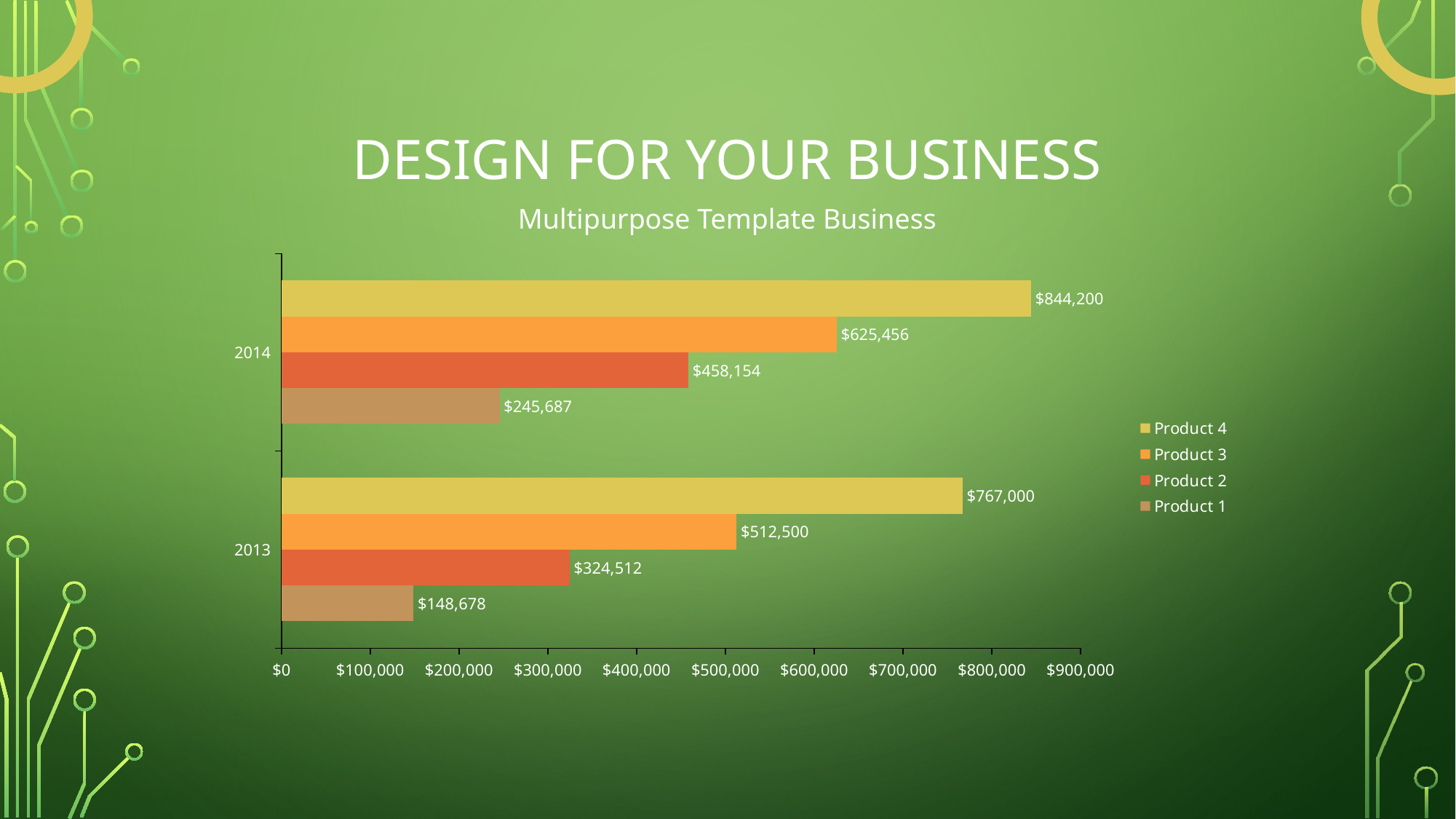
What is the value for Product 1 in 2013? $148,678 Which is larger: Product 3 in 2013 or Product 2 in 2014? Product 3 in 2013 What is the value for Product 4 in 2014? $844,200 What is the difference between the Product 4 values for 2014 and 2013? $77,200 How many series does the legend list? 4 Which product has the lowest value in 2014? Product 1 What is the value for Product 2 in 2014? $458,154 What kind of chart is shown on the slide? Bar chart Which legend entry is shown in red? Product 2 What is the difference between the Product 1 values for 2014 and 2013? $97,009 What is the value for Product 3 in 2013? $512,500 Which product has the highest value in 2013? Product 4